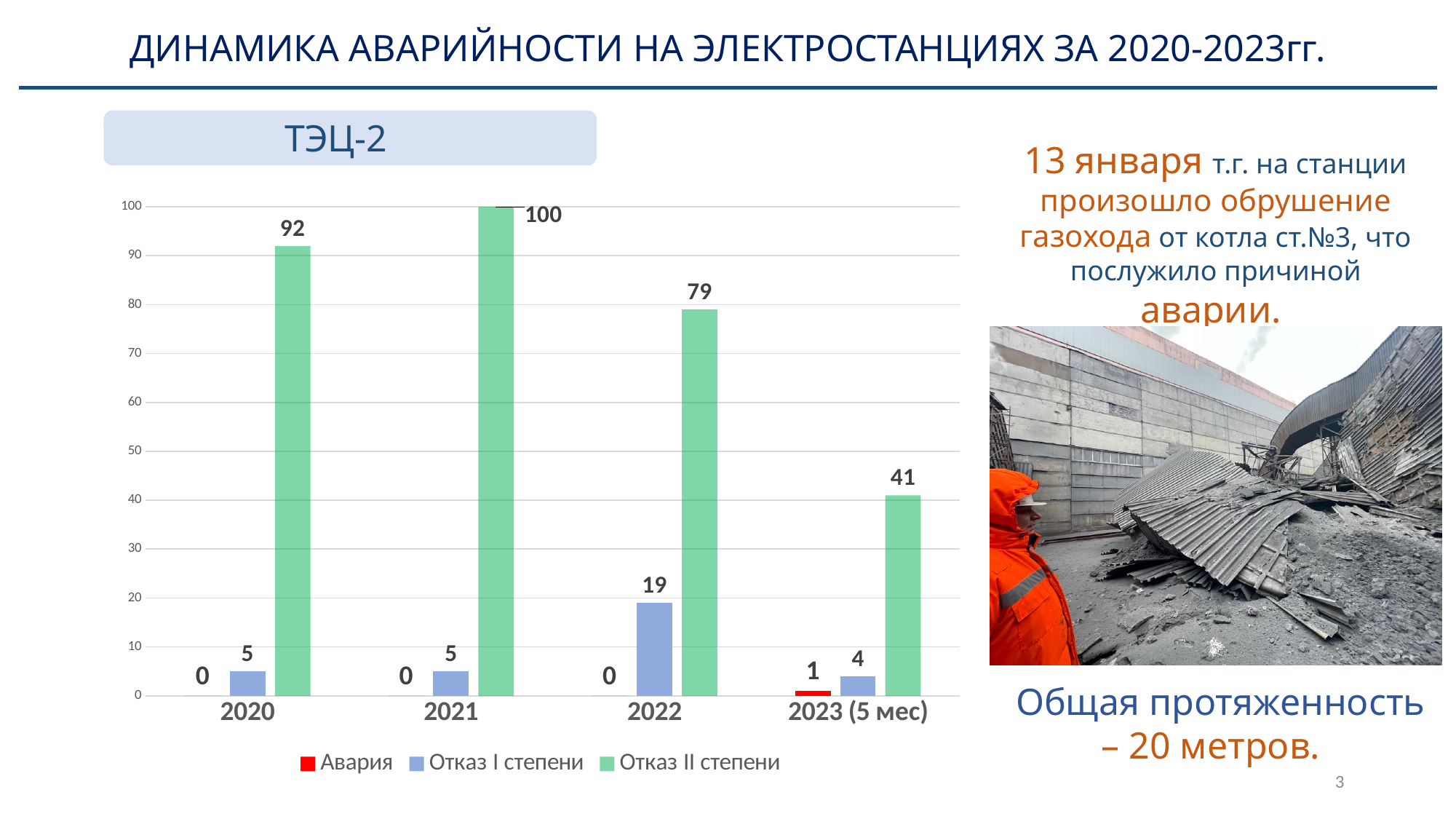
Does Отказ II степени rise or fall from 2021 to 2023 (5 мес)? fall What is the value of Авария for 2023 (5 мес)? 1 What is the value of Отказ II степени for 2021? 100 What is the difference between Отказ II степени in 2021 and 2022? 21 Which is larger: Отказ I степени in 2022 or in 2023 (5 мес)? 2022 What is the value of Отказ I степени for 2022? 19 What kind of chart is shown? bar chart How many categories are shown on the x axis? 4 How many series does the legend list? 3 Which year has the highest value for Отказ II степени? 2021 Which category has the lowest value for Отказ II степени? 2023 (5 мес) What colour represents the Авария series in the legend? red